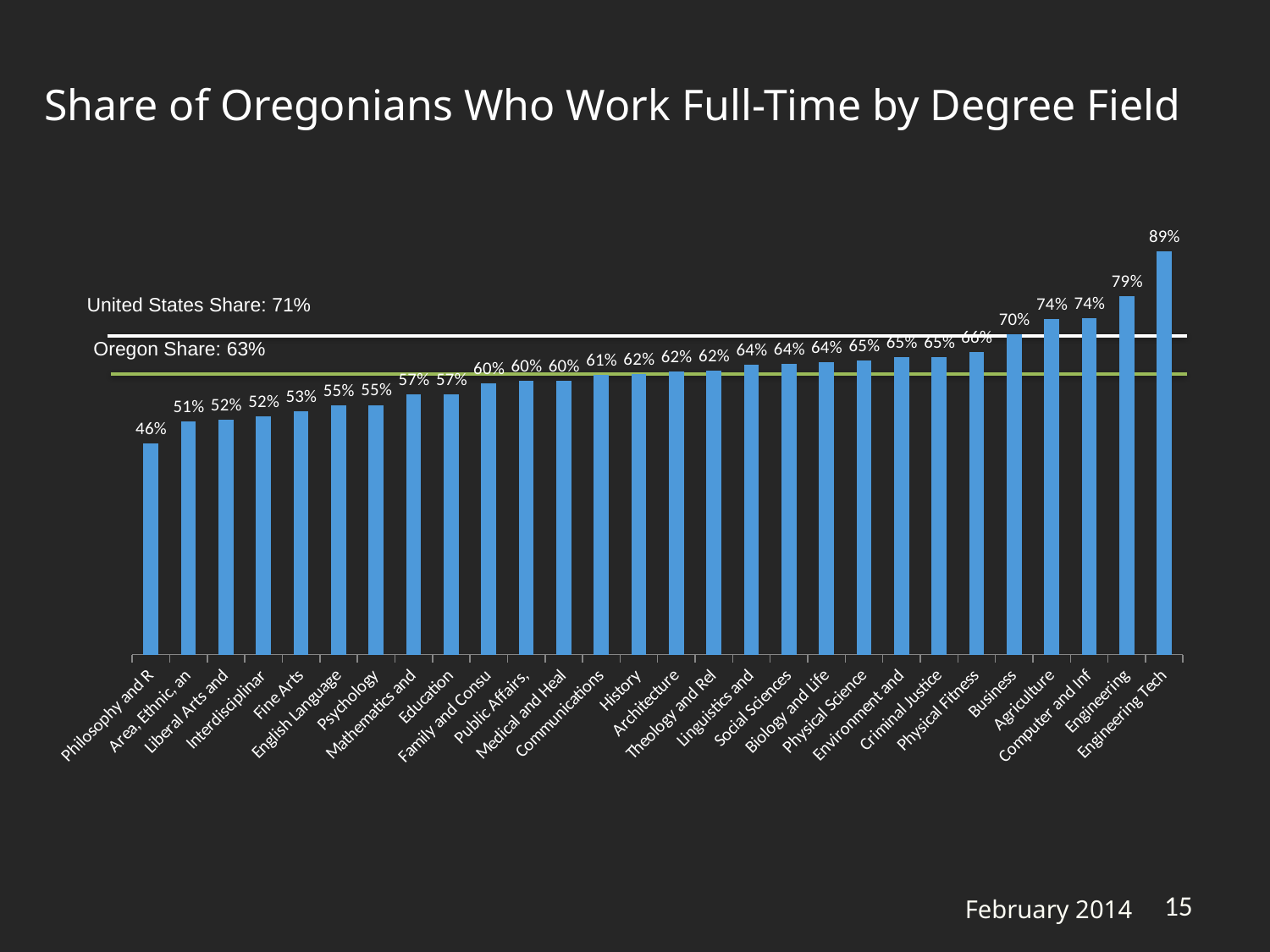
What is the difference between the Engineering Tech value and the Philosophy and R value? 43 percentage points What is the value shown for History? 62% What is the value shown for Fine Arts? 53% What United States share is marked by the horizontal reference line on the chart? 71% Which degree field has the highest share of full-time workers? Engineering Tech What kind of chart is shown on the slide? Bar chart How many degree fields are plotted as bars in the chart? 28 Do the bar values rise or fall from left to right along the x axis? Rise What is the share of Oregonians who work full-time for Engineering Tech? 89% Which is larger, the value for Engineering or the value for Agriculture? Engineering What is the value shown for Business? 70% Which degree field has the lowest share of full-time workers? Philosophy and R